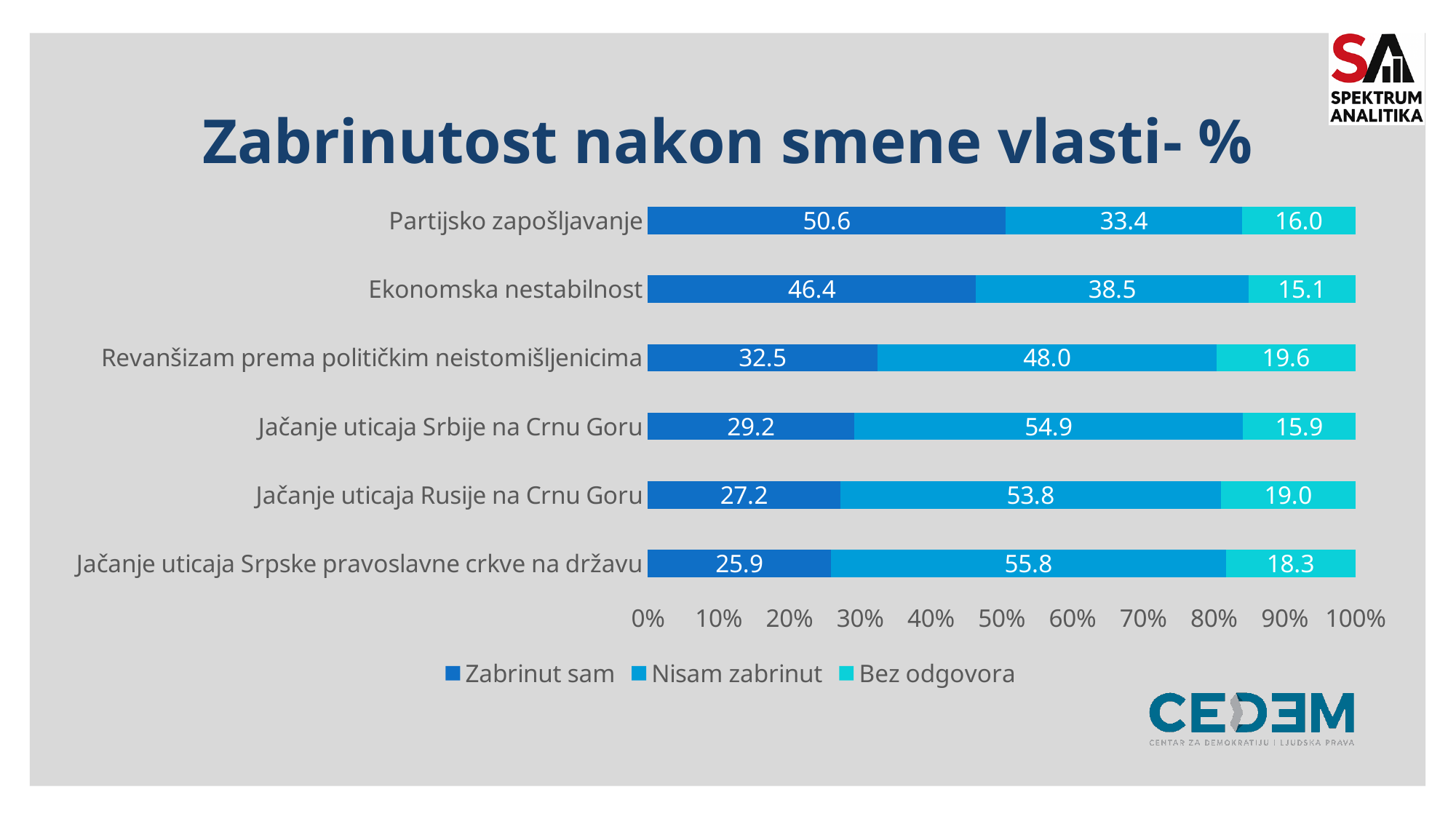
How many series does the legend list? 3 What is the 'Zabrinut sam' value for Partijsko zapošljavanje? 50.6 Which category has the highest 'Zabrinut sam' value? Partijsko zapošljavanje What kind of chart is shown on the slide? Stacked bar chart What is the 'Bez odgovora' value for Revanšizam prema političkim neistomišljenicima? 19.6 What is the total of the stacked bar for Ekonomska nestabilnost? 100.0 What is the 'Nisam zabrinut' value for Jačanje uticaja Srbije na Crnu Goru? 54.9 What is the title of the chart? Zabrinutost nakon smene vlasti- % Which is larger: the 'Nisam zabrinut' value for Jačanje uticaja Rusije na Crnu Goru or for Ekonomska nestabilnost? Jačanje uticaja Rusije na Crnu Goru Which category has the lowest 'Zabrinut sam' value? Jačanje uticaja Srpske pravoslavne crkve na državu How many categories are shown in the chart? 6 What is the difference between the 'Zabrinut sam' values for Partijsko zapošljavanje and Ekonomska nestabilnost? 4.2